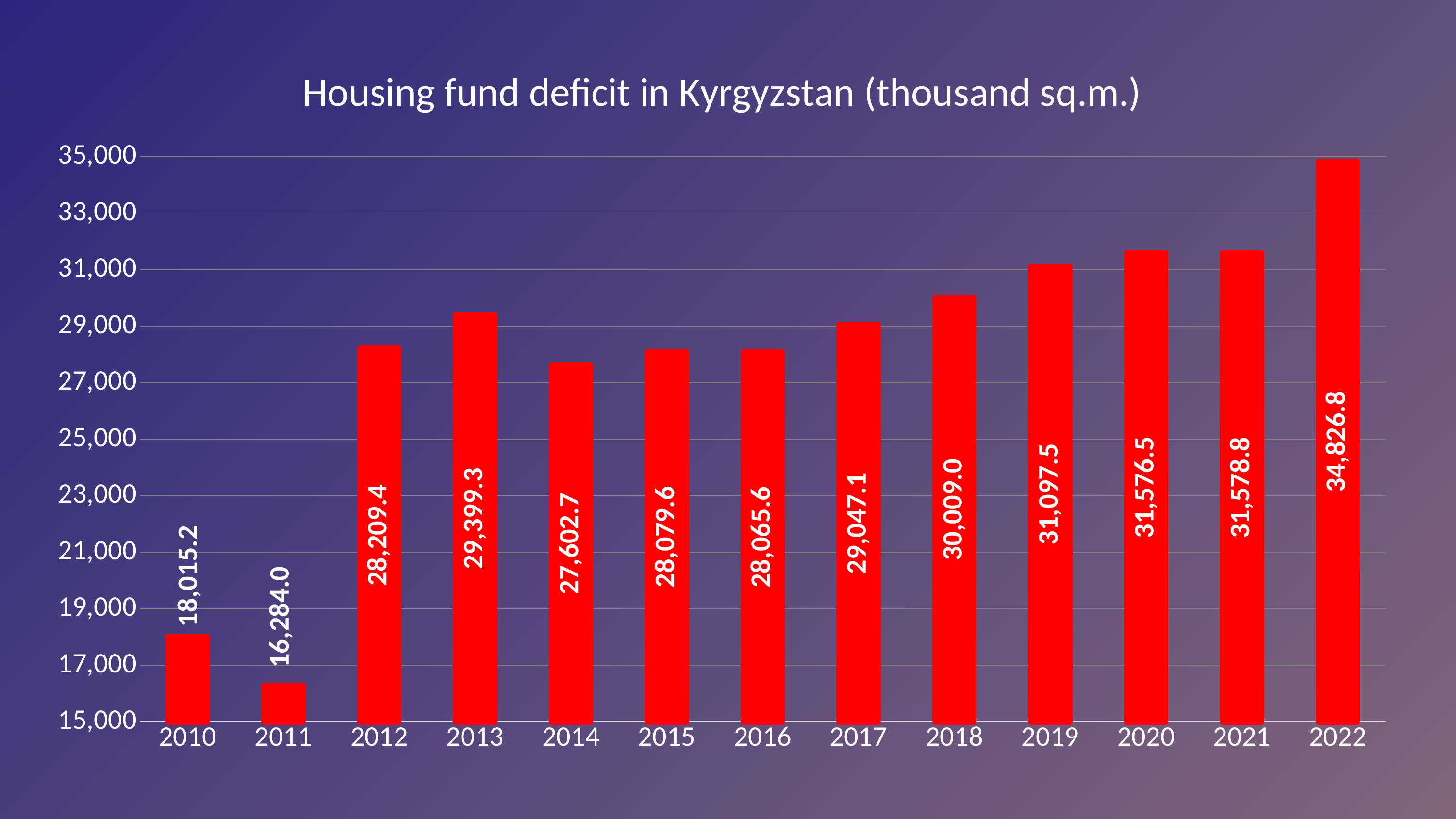
What type of chart is shown on the slide? bar chart What is the title of the chart? Housing fund deficit in Kyrgyzstan (thousand sq.m.) Which year has the larger value, 2013 or 2017? 2013 What is the difference between the values for 2022 and 2021? 3,248.0 What is the housing fund deficit value for 2014? 27,602.7 Which year has the highest housing fund deficit? 2022 What is the difference between the values for 2012 and 2011? 11,925.4 How many years are shown on the x axis of the chart? 13 What is the housing fund deficit value for 2018? 30,009.0 What is the housing fund deficit value for 2010? 18,015.2 Which year has the lowest housing fund deficit? 2011 Is the value for 2019 greater or less than 31,000? greater